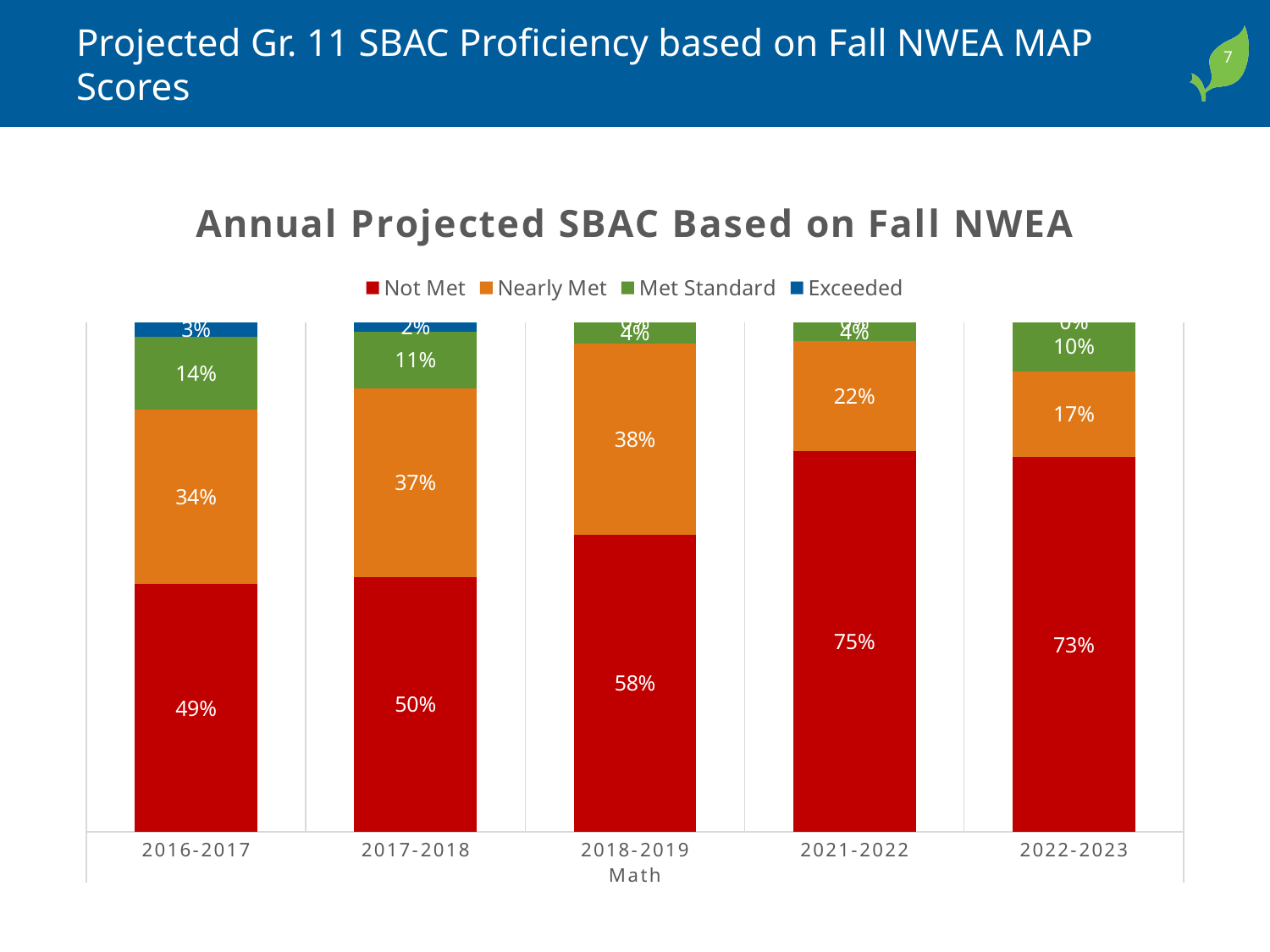
What is the Nearly Met value for 2018-2019? 38% What is the Exceeded value for 2017-2018? 2% What is the Not Met value for 2021-2022? 75% Which is larger, the Nearly Met value for 2017-2018 or for 2022-2023? 2017-2018 Which school year has the lowest Nearly Met value? 2022-2023 What is the difference between the Not Met values for 2021-2022 and 2016-2017? 26% Which school year has the highest Not Met value? 2021-2022 How many school-year categories are shown on the x axis? 5 How many series does the legend list? 4 What type of chart is shown on the slide? stacked bar chart What is the Met Standard value for 2016-2017? 14% What is the title of the chart? Annual Projected SBAC Based on Fall NWEA